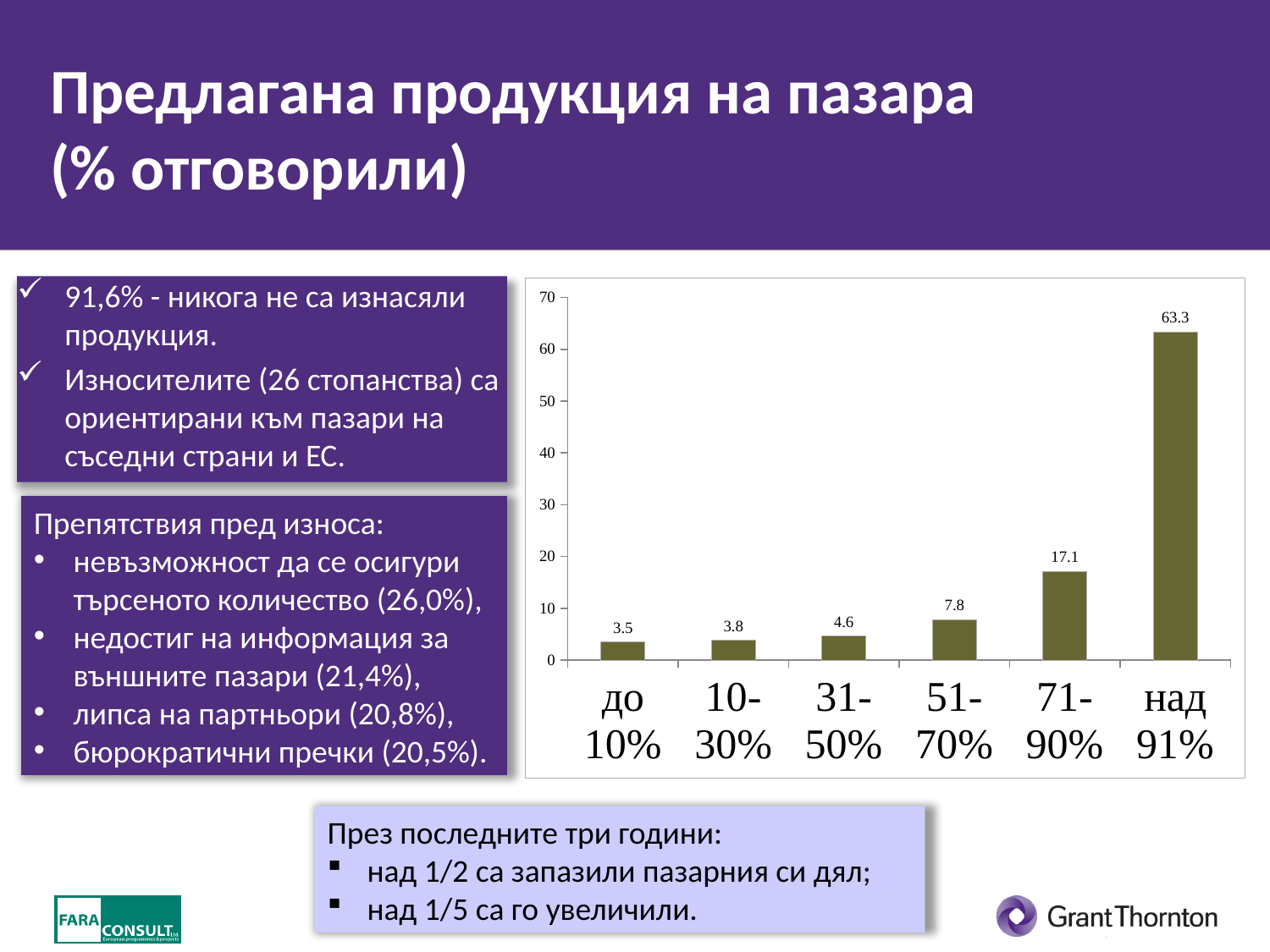
What is the value for the category 'до 10%'? 3.5 What is the value for the category 'над 91%'? 63.3 What is the value for the category '71-90%'? 17.1 Do the values rise or fall from left to right along the x axis? rise What is the difference between the values for 'над 91%' and '71-90%'? 46.2 What kind of chart is shown on the slide? bar chart Which category has the lowest value? до 10% Is the value for '71-90%' greater or less than 20? less Which is larger, the value for '31-50%' or the value for '51-70%'? 51-70% How many categories are shown on the x axis? 6 What is the value for the category '51-70%'? 7.8 Which category has the highest value? над 91%